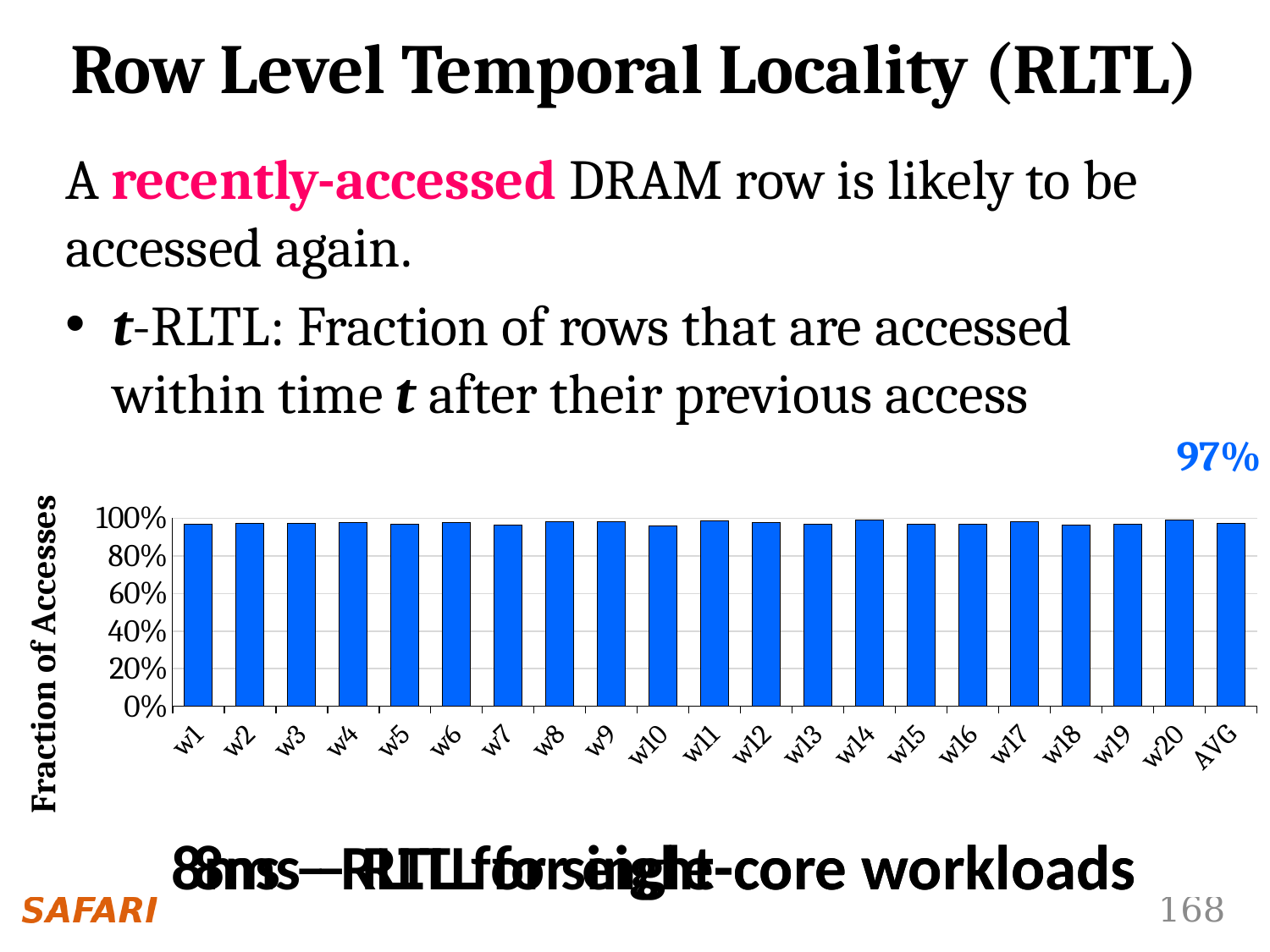
What is the value labelled for the AVG bar in the chart? 97% Is the value for w20 greater or less than 40%? greater Is the value for w1 greater or less than 80%? greater What kind of chart is shown on the slide? bar chart What is the label of the y axis of the chart? Fraction of Accesses What is the highest tick value shown on the y axis? 100% What is the label of the last category on the x axis? AVG What is the label of the first category on the x axis? w1 How many categories are shown along the x axis of the chart? 21 Is the value for w10 greater or less than 60%? greater